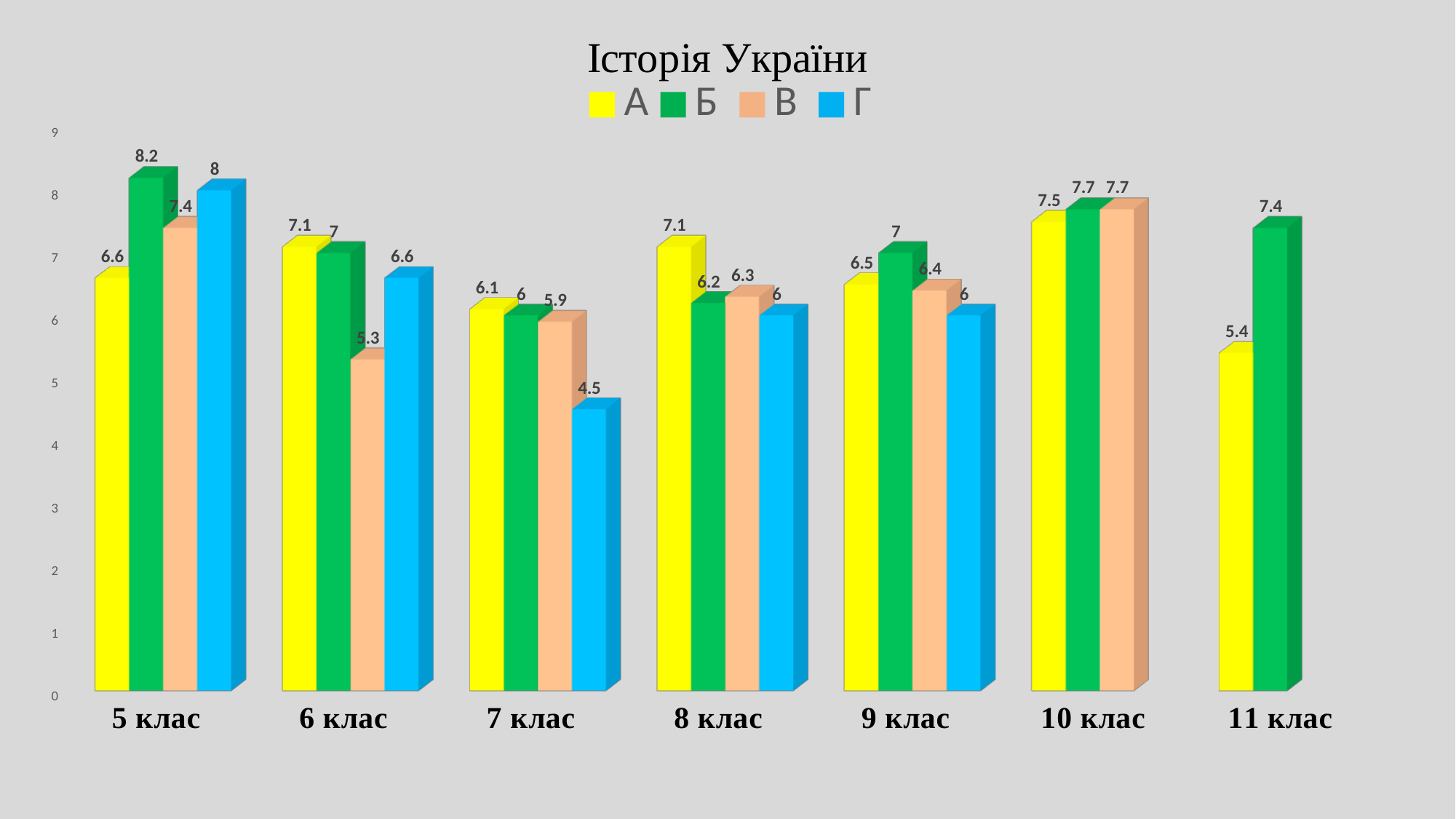
How many series does the legend list? 4 What kind of chart is shown on the slide? Bar chart What is the value for series А in 11 клас? 5.4 Which category has the highest value for series Б? 5 клас Which category has the lowest value for series Г? 7 клас Which is larger in 8 клас: series А or series Б? А What is the value for series В in 6 клас? 5.3 What is the title of the chart? Історія України What is the difference between series Б and series А in 11 клас? 2 What is the value for series Б in 5 клас? 8.2 How many categories (classes) are shown on the x axis? 7 What is the value for series Г in 7 клас? 4.5